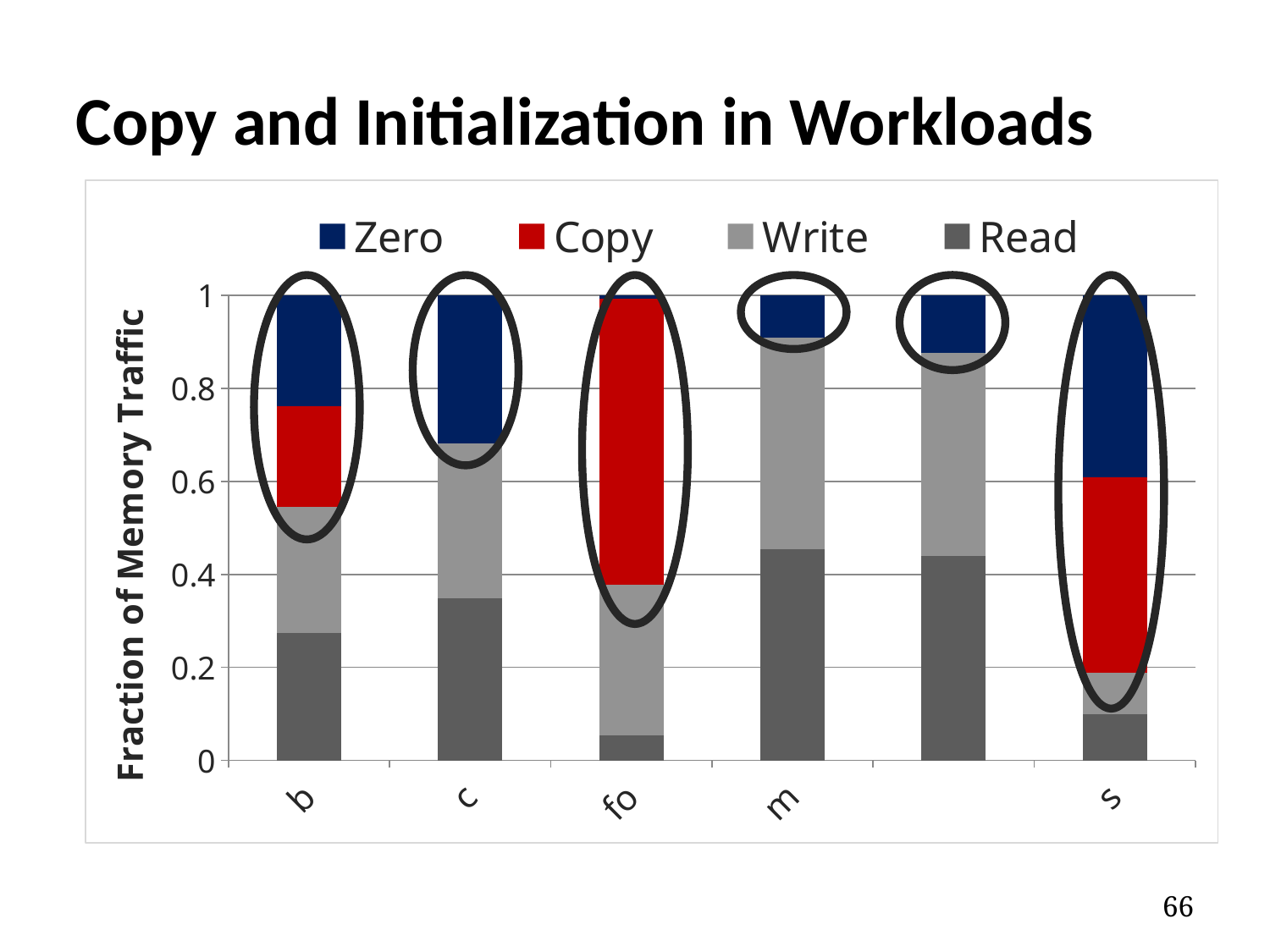
What are the series names listed in the legend? Zero, Copy, Write, Read What is the title of the y axis? Fraction of Memory Traffic What kind of chart is shown on the slide? Stacked bar chart How many bars are plotted in the chart? 6 Is the Read value for s greater or less than 0.2? less Is the Read value for b greater or less than 0.4? less Is the Read value for m greater or less than 0.4? greater What is the total height of the stacked bar for b? 1 How many series does the legend list? 4 Which category has the largest Copy segment? fo Which is larger, the Copy value for b or the Copy value for s? s Which is larger, the Read value for b or the Read value for c? c